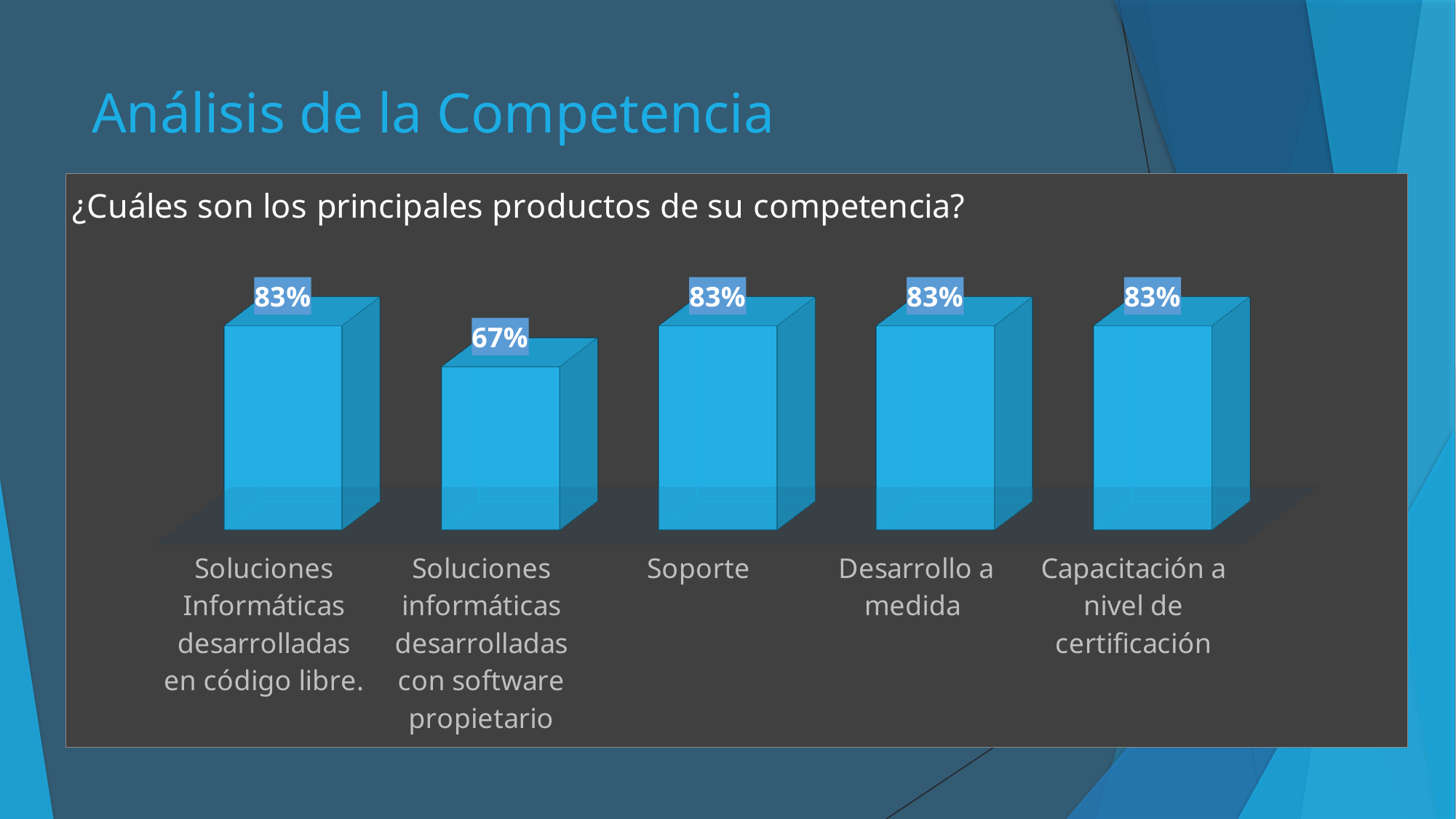
What value is shown for Capacitación a nivel de certificación? 83% How many categories share the value 83%? 4 What value is shown for Soluciones informáticas desarrolladas con software propietario? 67% How many categories are shown in the chart? 5 What value is shown for Soluciones Informáticas desarrolladas en código libre? 83% What value is shown for Soporte? 83% What is the difference between the value for Soporte and the value for Soluciones informáticas desarrolladas con software propietario? 16% What is the title of the chart? ¿Cuáles son los principales productos de su competencia? Which category has the lowest value? Soluciones informáticas desarrolladas con software propietario What kind of chart is shown on the slide? Bar chart What value is shown for Desarrollo a medida? 83% Which is larger: the value for Desarrollo a medida or the value for Soluciones informáticas desarrolladas con software propietario? Desarrollo a medida